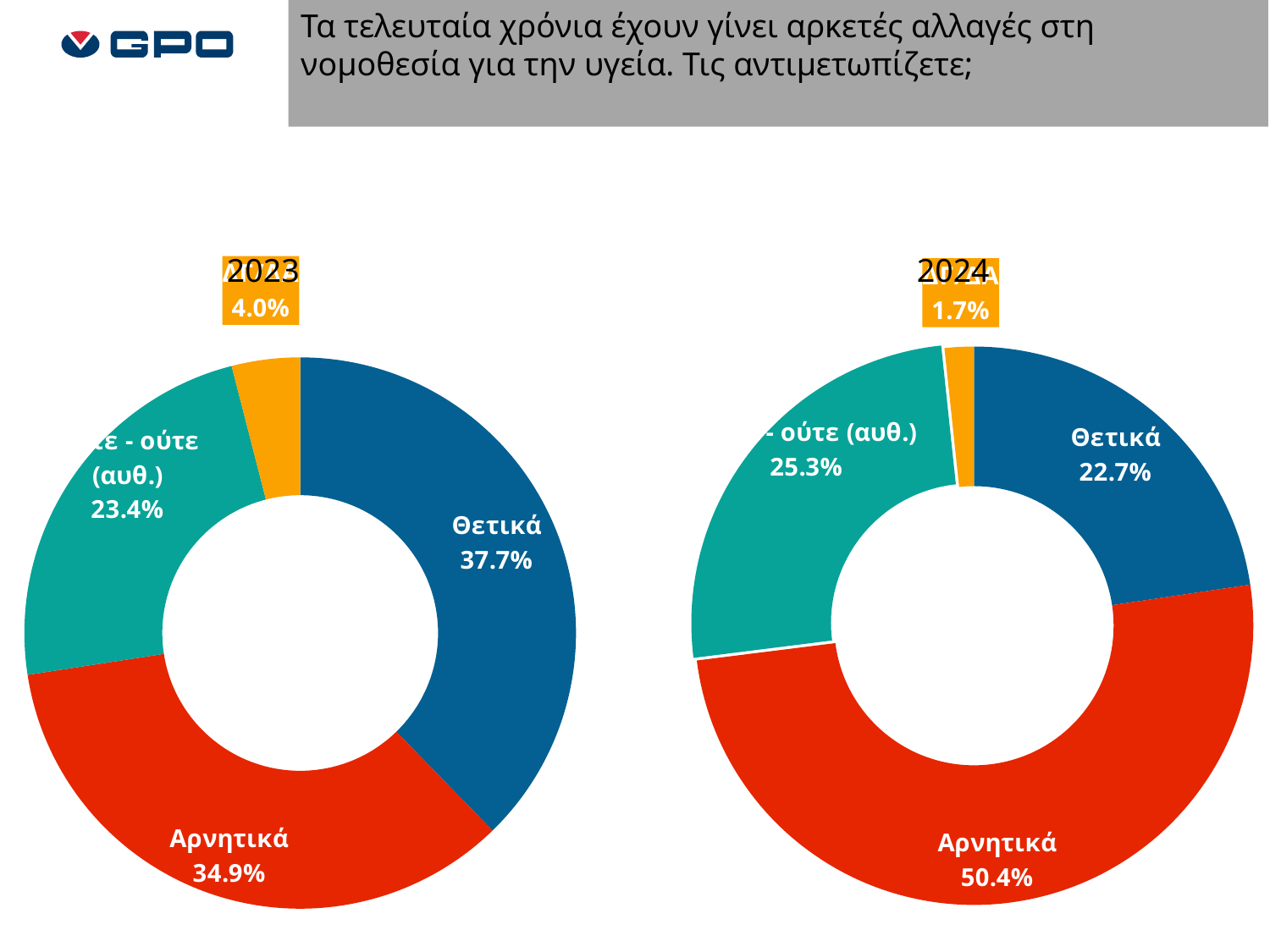
In the 2023 chart, what is the share for Αρνητικά? 34.9% In the 2023 chart, which is larger, Θετικά or Αρνητικά? Θετικά What is the share of the orange slice in the 2023 chart? 4.0% In the 2024 chart, what is the share for Ούτε - ούτε (αυθ.)? 25.3% In the 2024 chart, which category has the largest share? Αρνητικά How many slices does the 2024 chart have? 4 What kind of chart is the 2023 chart? Pie (donut) chart In the 2024 chart, what is the share for Αρνητικά? 50.4% In the 2024 chart, what is the share for Θετικά? 22.7% In the 2024 chart, what is the difference in percentage points between Αρνητικά and Θετικά? 27.7 In the 2023 chart, what is the share for Θετικά? 37.7% In the 2023 chart, which category has the largest share? Θετικά